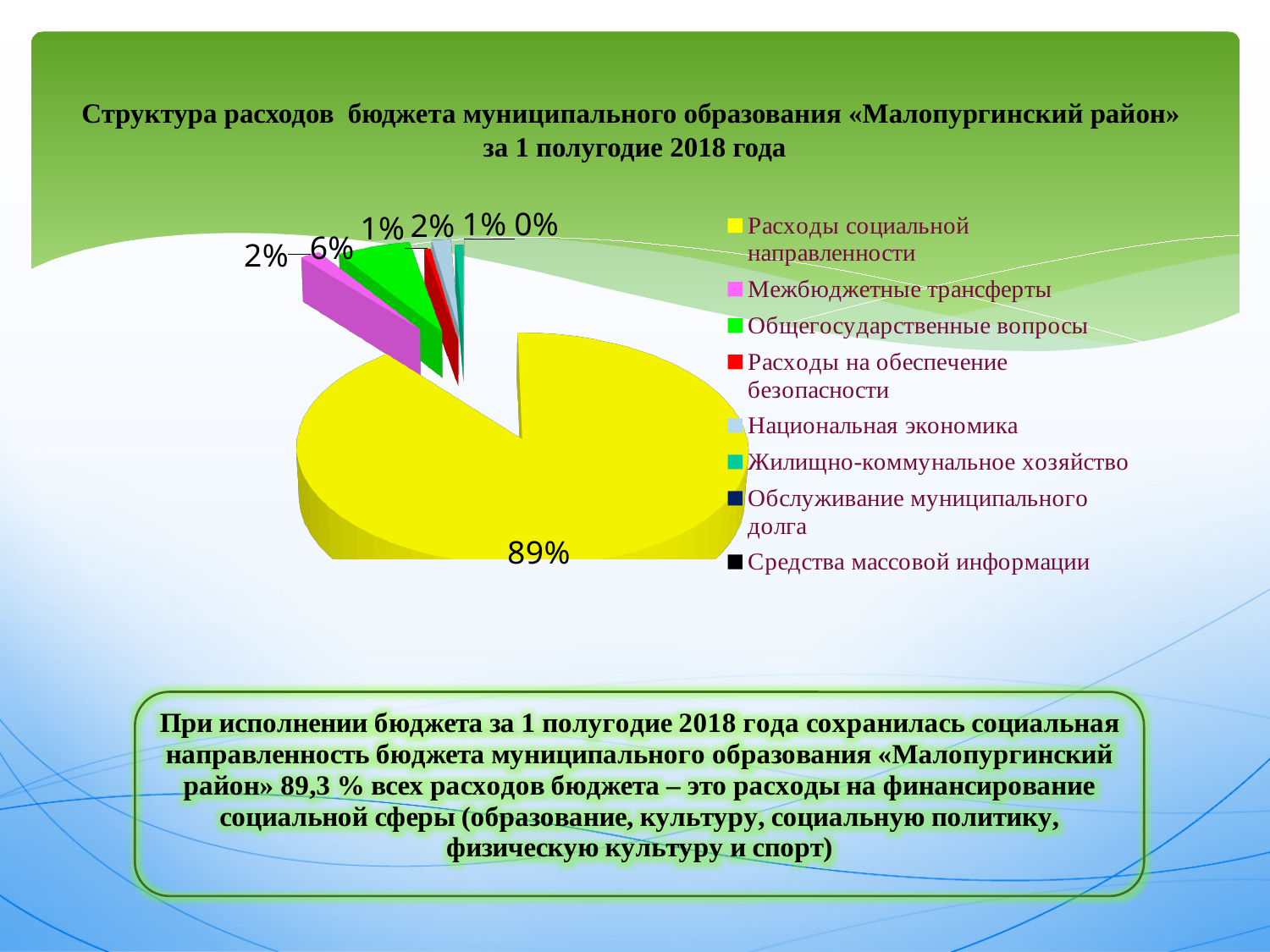
What is the title of the chart? Структура расходов бюджета муниципального образования «Малопургинский район» за 1 полугодие 2018 года What colour is the slice for Расходы социальной направленности? Yellow What percentage is shown for Расходы социальной направленности? 89% Is the share for Расходы социальной направленности greater or less than 50%? greater Which is larger: the share for Расходы социальной направленности or the share for Межбюджетные трансферты? Расходы социальной направленности What is the largest percentage label shown on the pie? 89% What is the smallest percentage label shown on the pie? 0% How many categories does the legend list? 8 What kind of chart is shown on the slide? Pie chart Which category has the largest share of the pie? Расходы социальной направленности